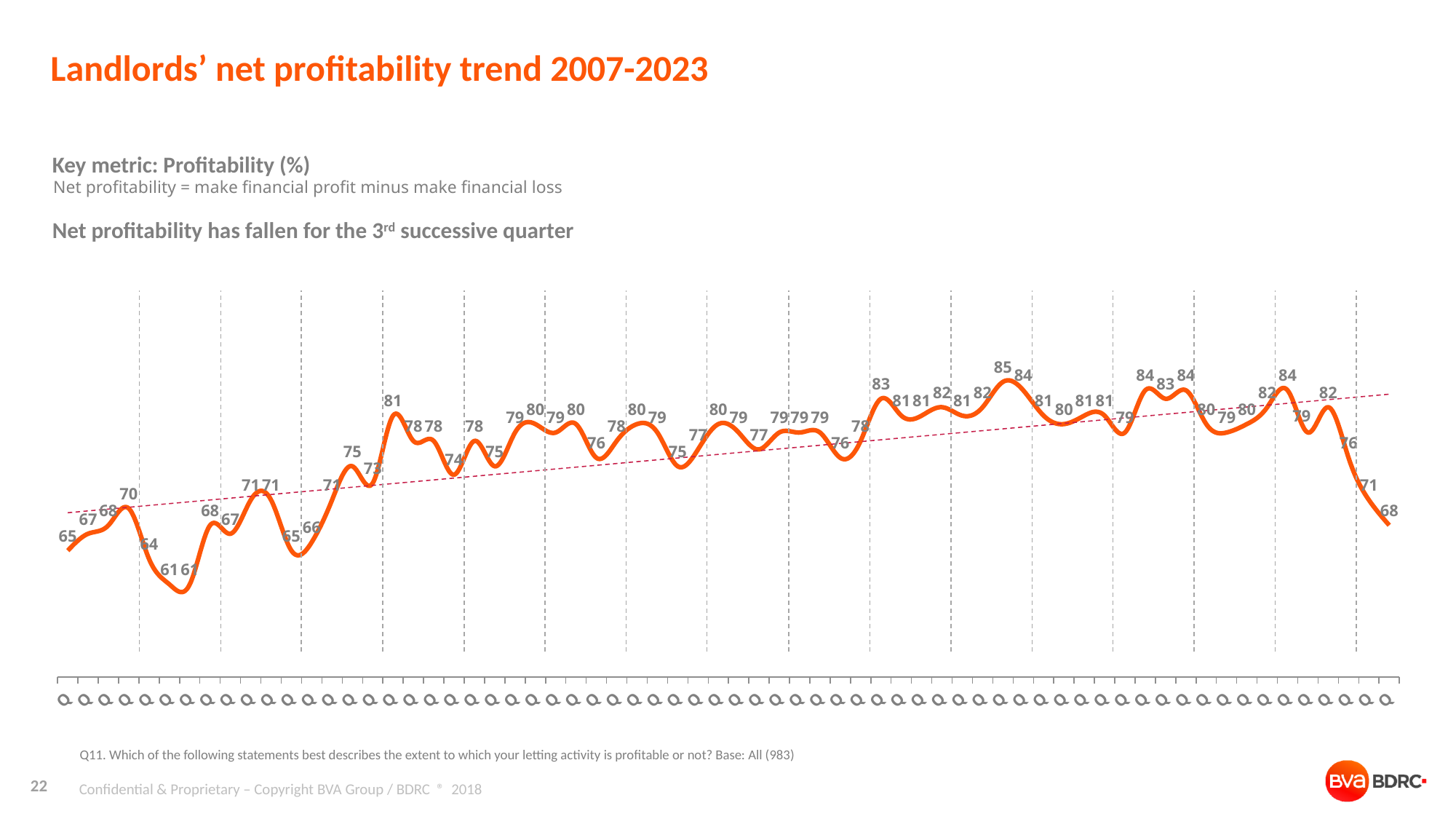
What is the value of the last data point on the right of the chart? 68 What is the value of the first data point on the left of the chart? 65 Which is larger, the first data point or the last data point on the chart? the last data point (68) What is the lowest net profitability value plotted on the chart? 61 What is the highest net profitability value plotted on the chart? 85 By how much does the last data point exceed the first data point on the chart? 3 What kind of chart is shown on the slide? line chart What is the title of the chart on the slide? Landlords' net profitability trend 2007-2023 What colour is the plotted line on the chart? orange What is the difference between the highest and lowest values plotted on the chart? 24 How many data points on the chart have a value of 85? 1 Over the whole period, does the dashed trend line rise or fall from left to right? rise